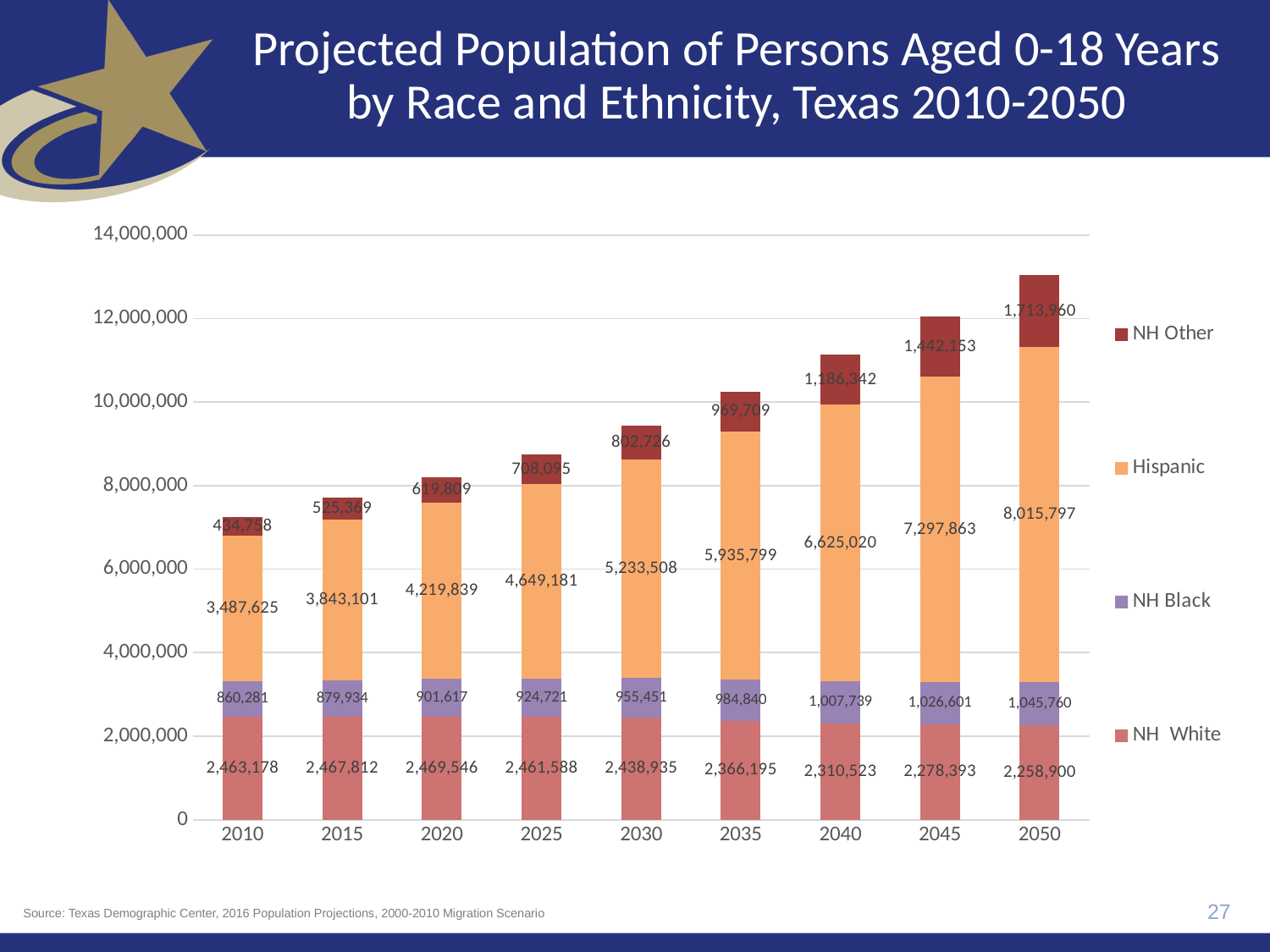
In which year is the NH White value lowest? 2050 What kind of chart is shown on the slide? Stacked bar chart What is the projected Hispanic population aged 0-18 in Texas in 2050? 8,015,797 What is the NH White value for 2010? 2,463,178 What is the NH Black value for 2030? 955,451 In which year is the Hispanic value highest? 2050 How many series does the legend list? 4 Is the total height of the 2050 stacked bar greater or less than 12,000,000? greater By how much does the Hispanic value increase from 2010 to 2050? 4,528,172 What is the difference between the NH Black values for 2050 and 2010? 185,479 Which is larger in 2040, the NH White value or the NH Black value? NH White How many years are shown on the x axis? 9